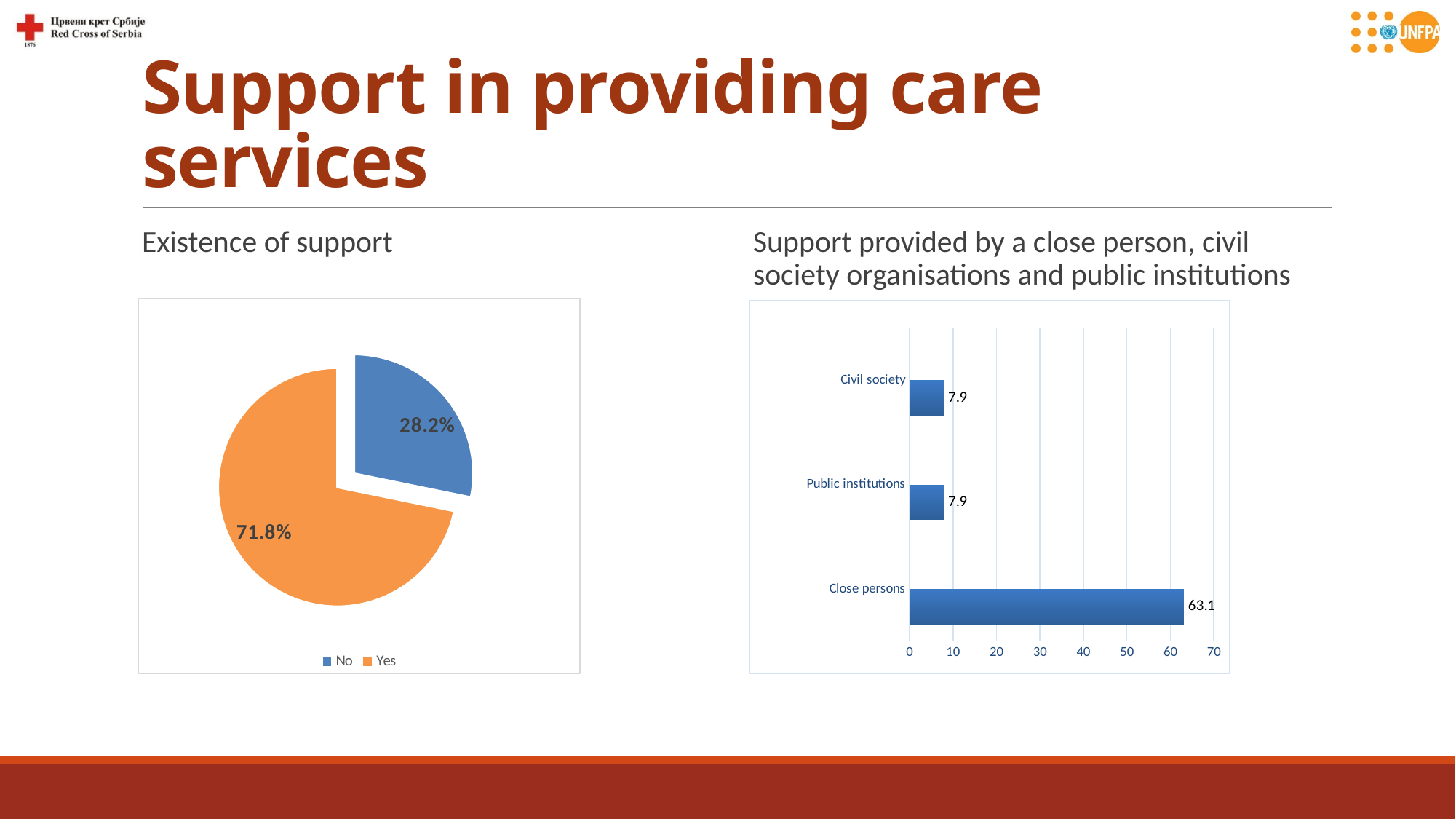
In the 'Existence of support' pie chart, what colour is the 'Yes' slice? Orange In the 'Existence of support' pie chart, what share is labelled for 'No'? 28.2% What kind of chart is the 'Existence of support' chart? Pie chart In the 'Existence of support' pie chart, what share is labelled for 'Yes'? 71.8% In the 'Existence of support' pie chart, how many entries does the legend list? 2 In the chart on the right, what is the value for 'Close persons'? 63.1 In the chart on the right, what is the value for 'Civil society'? 7.9 In the chart on the right, what is the difference between the values for 'Close persons' and 'Public institutions'? 55.2 In the 'Existence of support' pie chart, which slice is larger, 'Yes' or 'No'? Yes How many categories are shown in the chart on the right? 3 What kind of chart is the chart on the right? Bar chart In the chart on the right, which category has the highest value? Close persons